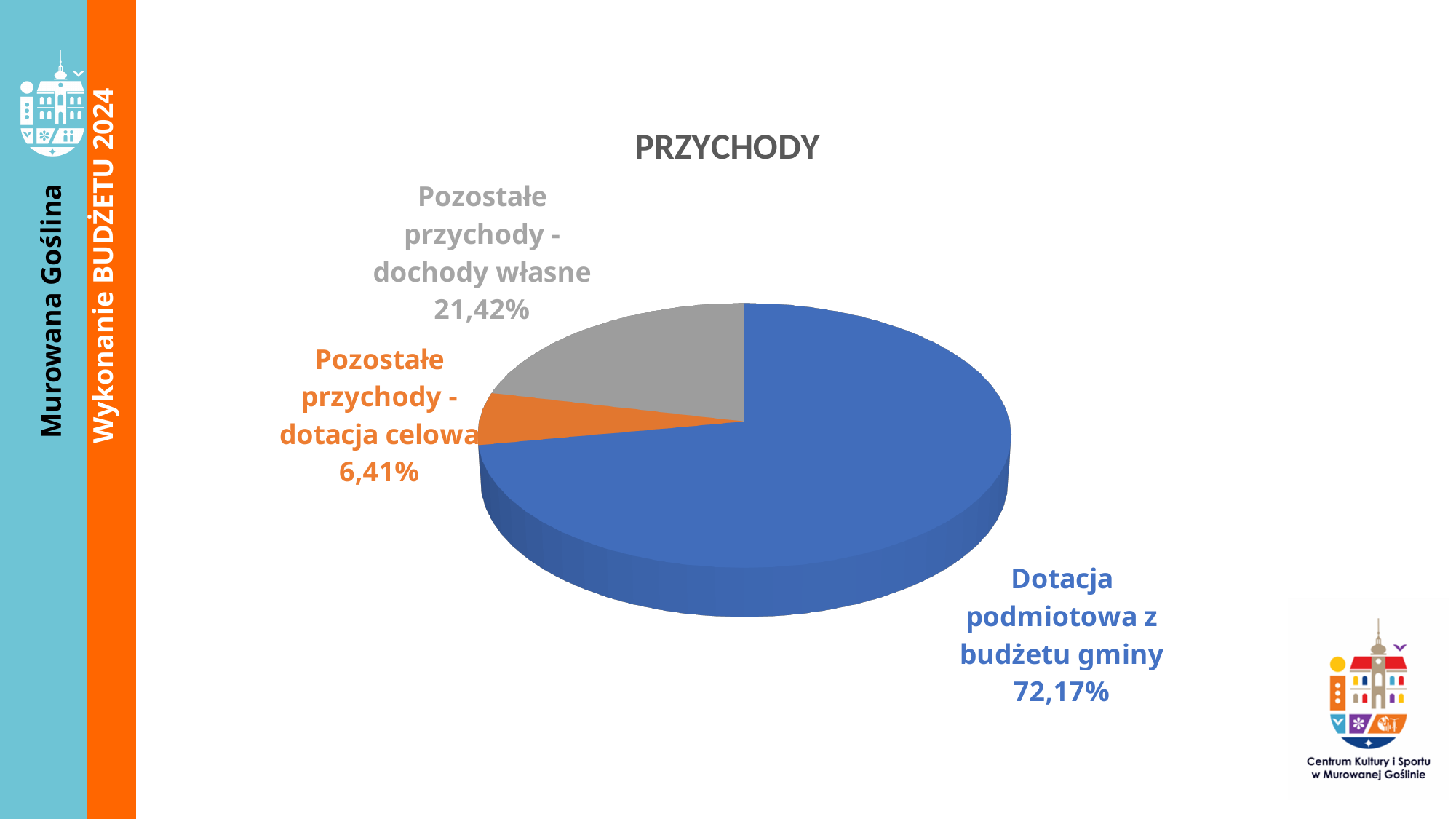
What share of the pie is 'Pozostałe przychody - dochody własne'? 21,42% Which is larger: 'Pozostałe przychody - dochody własne' or 'Pozostałe przychody - dotacja celowa'? Pozostałe przychody - dochody własne What is the title of the pie chart? PRZYCHODY What share of the pie is 'Pozostałe przychody - dotacja celowa'? 6,41% Which category has the smallest share of the pie? Pozostałe przychody - dotacja celowa How many slices does the pie chart have? 3 What is the difference in percentage points between 'Pozostałe przychody - dochody własne' and 'Pozostałe przychody - dotacja celowa'? 15,01 What is the difference in percentage points between 'Dotacja podmiotowa z budżetu gminy' and 'Pozostałe przychody - dochody własne'? 50,75 Which category has the largest share of the pie? Dotacja podmiotowa z budżetu gminy What type of chart is shown on the slide? pie chart What colour is the slice for 'Pozostałe przychody - dotacja celowa'? orange What share of the pie is 'Dotacja podmiotowa z budżetu gminy'? 72,17%